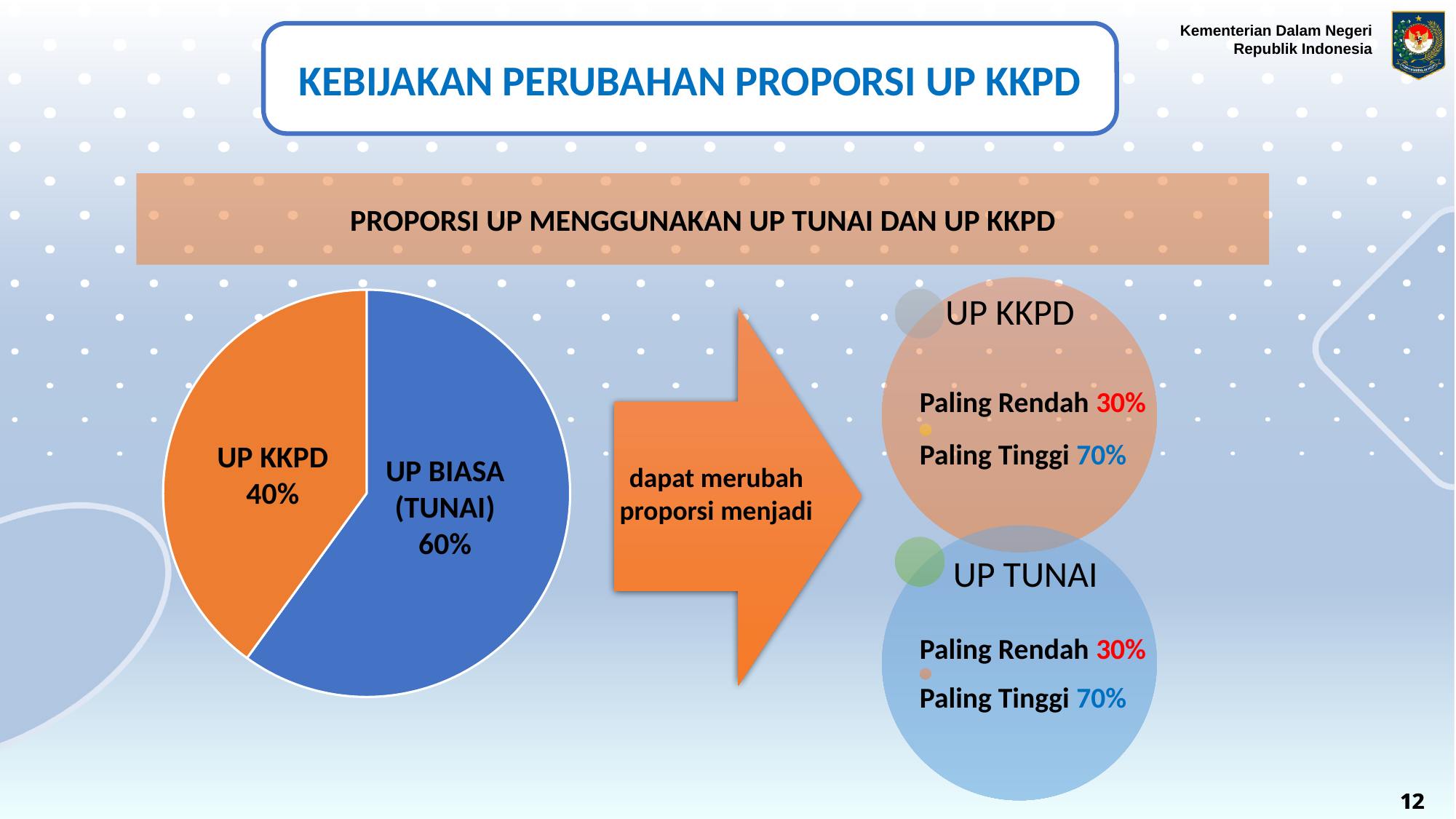
Which is larger in the pie chart, UP KKPD or UP BIASA (TUNAI)? UP BIASA (TUNAI) Which slice of the pie chart is the smallest? UP KKPD What is the share of UP KKPD in the pie chart? 40% What colour is the UP KKPD slice in the pie chart? orange What kind of chart is shown on the slide? pie chart What is the total of the two slices in the pie chart? 100% What is the difference between the UP BIASA (TUNAI) share and the UP KKPD share? 20% How many slices does the pie chart have? 2 Which slice of the pie chart is the largest? UP BIASA (TUNAI) What is the share of UP BIASA (TUNAI) in the pie chart? 60% What colour is the UP BIASA (TUNAI) slice in the pie chart? blue